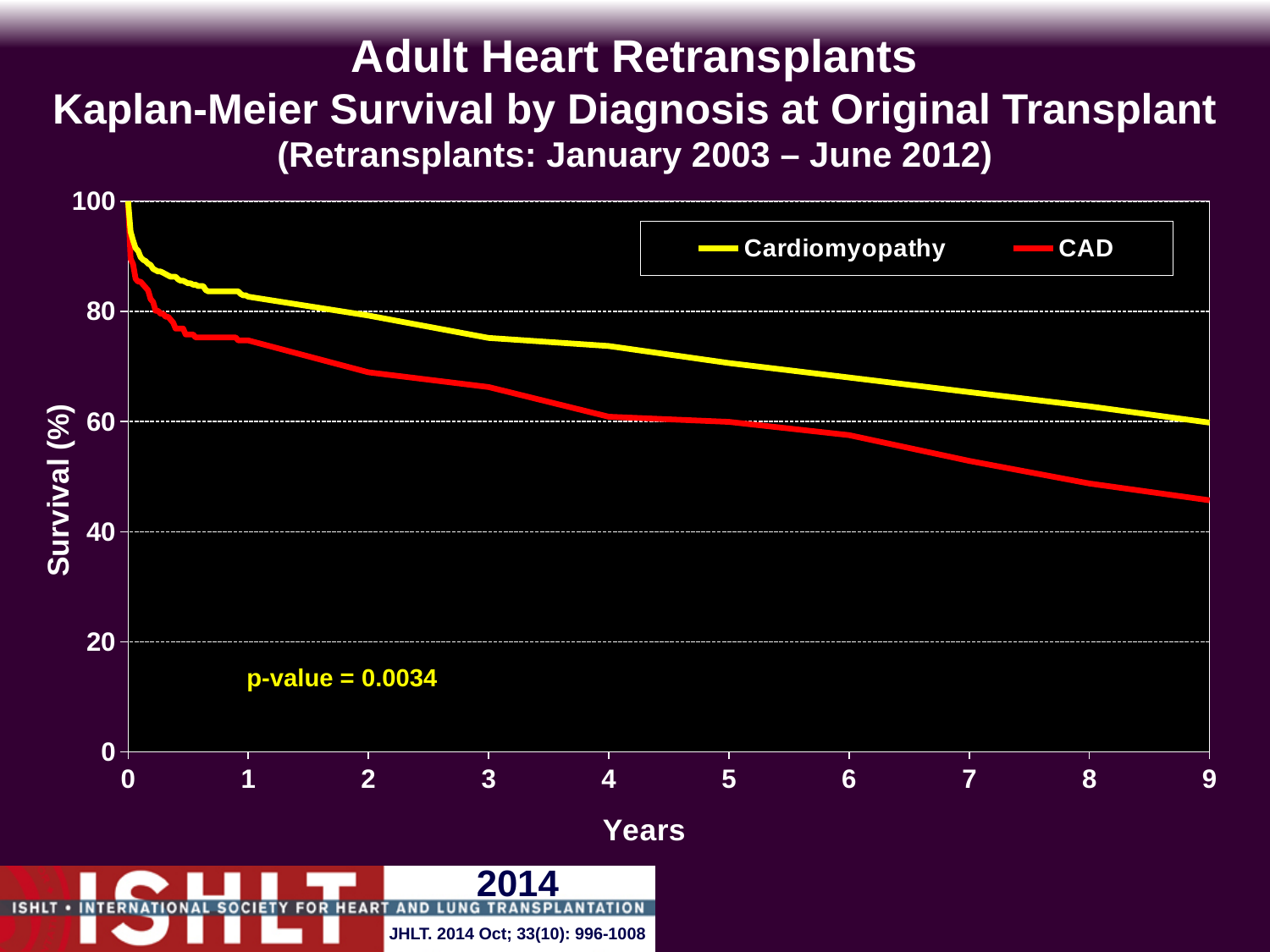
What p-value is printed on the chart? p-value = 0.0034 Which two diagnosis groups are plotted in the chart? Cardiomyopathy and CAD How many series does the legend list? 2 Is the survival for CAD at year 9 greater or less than 60? less What kind of chart is shown on the slide? Line chart Is the survival for Cardiomyopathy at year 6 greater or less than 80? less What is the maximum value shown on the Years axis? 9 Which group has the lower survival at year 9? CAD At year 5, which group has the higher survival, Cardiomyopathy or CAD? Cardiomyopathy Is the survival for CAD at year 2 greater or less than 80? less Do the survival curves rise or fall as years increase? Fall